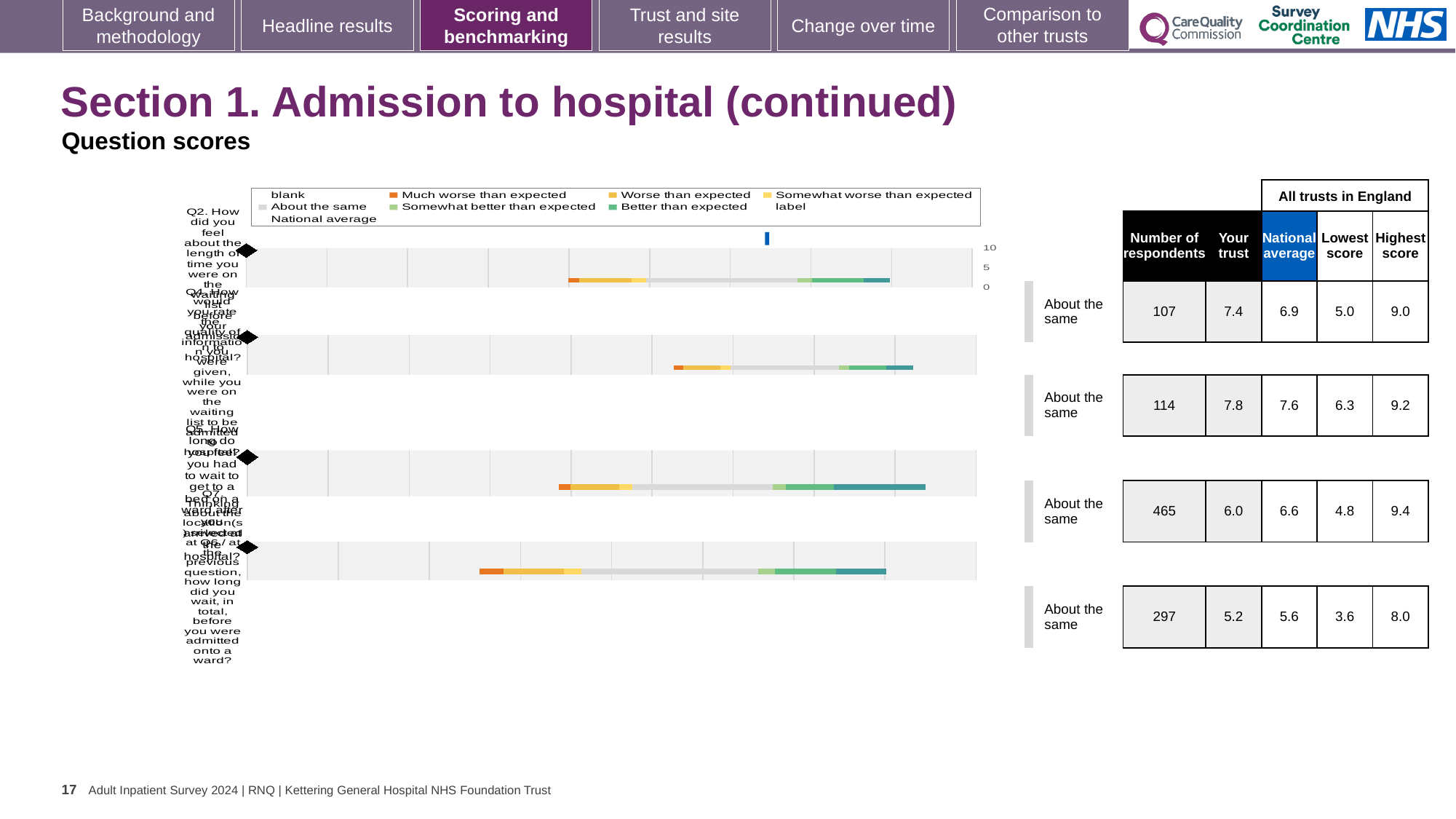
What benchmark category is shown next to every row of the chart? About the same For the third row, which is larger: the 'Your trust' score or the national average? National average For the fourth row, what is the lowest score among all trusts in England? 3.6 Which row has the lowest 'Your trust' score in the table beside the chart? the fourth row (5.2) What kind of chart is shown on the slide? bar chart What is the maximum value shown on the chart's score axis? 10 In the table beside the chart, what is the 'Your trust' score for the first (top) row? 7.4 How many question rows (bars) does the chart contain? 4 Which row has the highest 'Your trust' score in the table beside the chart? the second row (7.8) In the table beside the chart, how many respondents are listed for the third row? 465 For the first row, what is the difference between the 'Your trust' score and the national average? 0.5 In the table beside the chart, what is the highest score for the fourth (bottom) row? 8.0